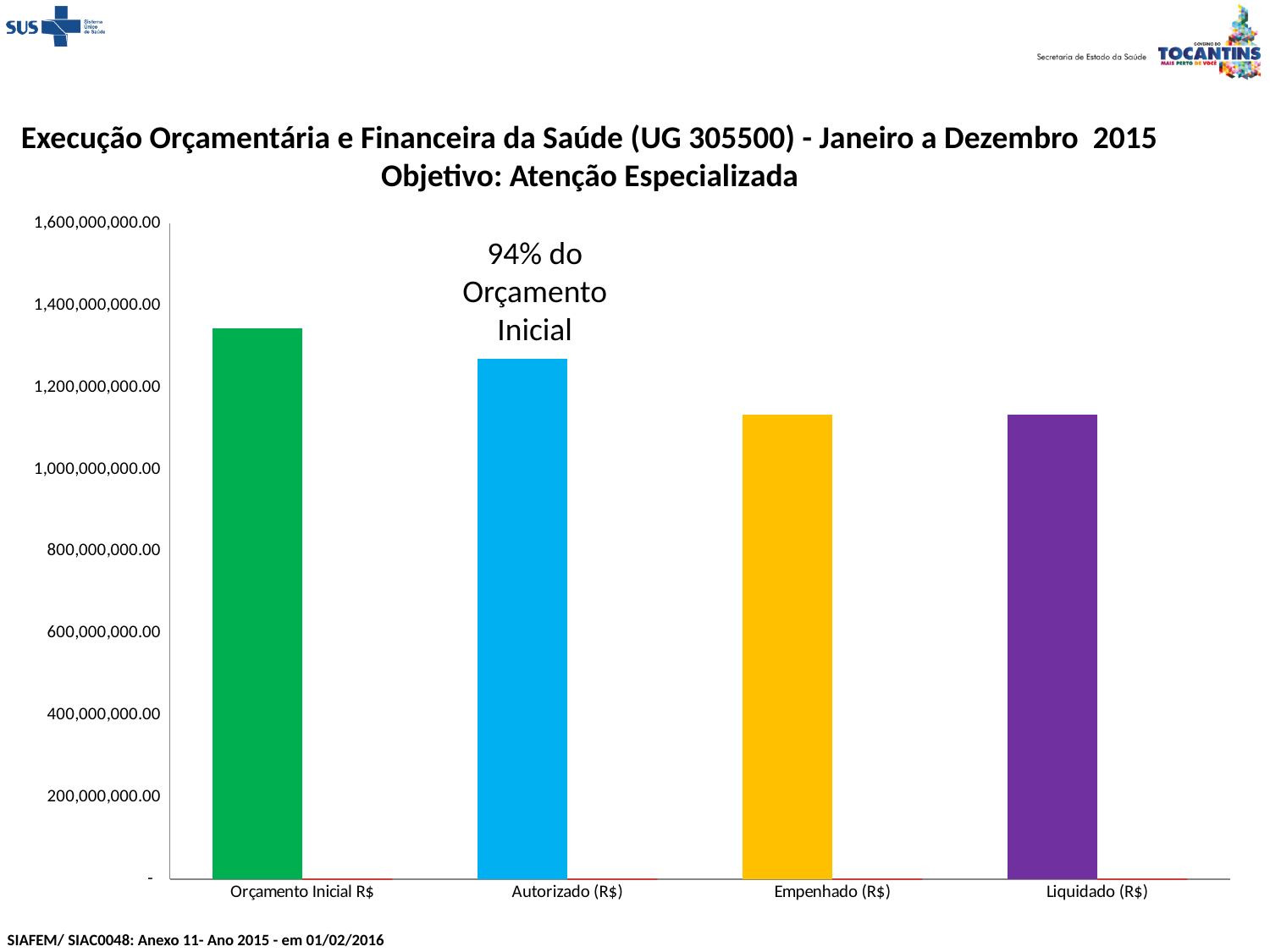
What kind of chart is shown on the slide? bar chart Which category has the highest bar in the chart? Orçamento Inicial R$ Is the value for Orçamento Inicial R$ greater or less than 1,200,000,000.00? greater Do the bar values rise or fall from left to right along the x axis? fall Is the value for Liquidado (R$) greater or less than 1,000,000,000.00? greater Which is larger, the value for Autorizado (R$) or the value for Empenhado (R$)? Autorizado (R$) What does the text annotation above the Autorizado (R$) bar say? 94% do Orçamento Inicial What objective is named in the second line of the chart title? Atenção Especializada Is the value for Empenhado (R$) greater or less than 1,200,000,000.00? less How many categories are plotted on the x axis of the chart? 4 Which is larger, the value for Orçamento Inicial R$ or the value for Autorizado (R$)? Orçamento Inicial R$